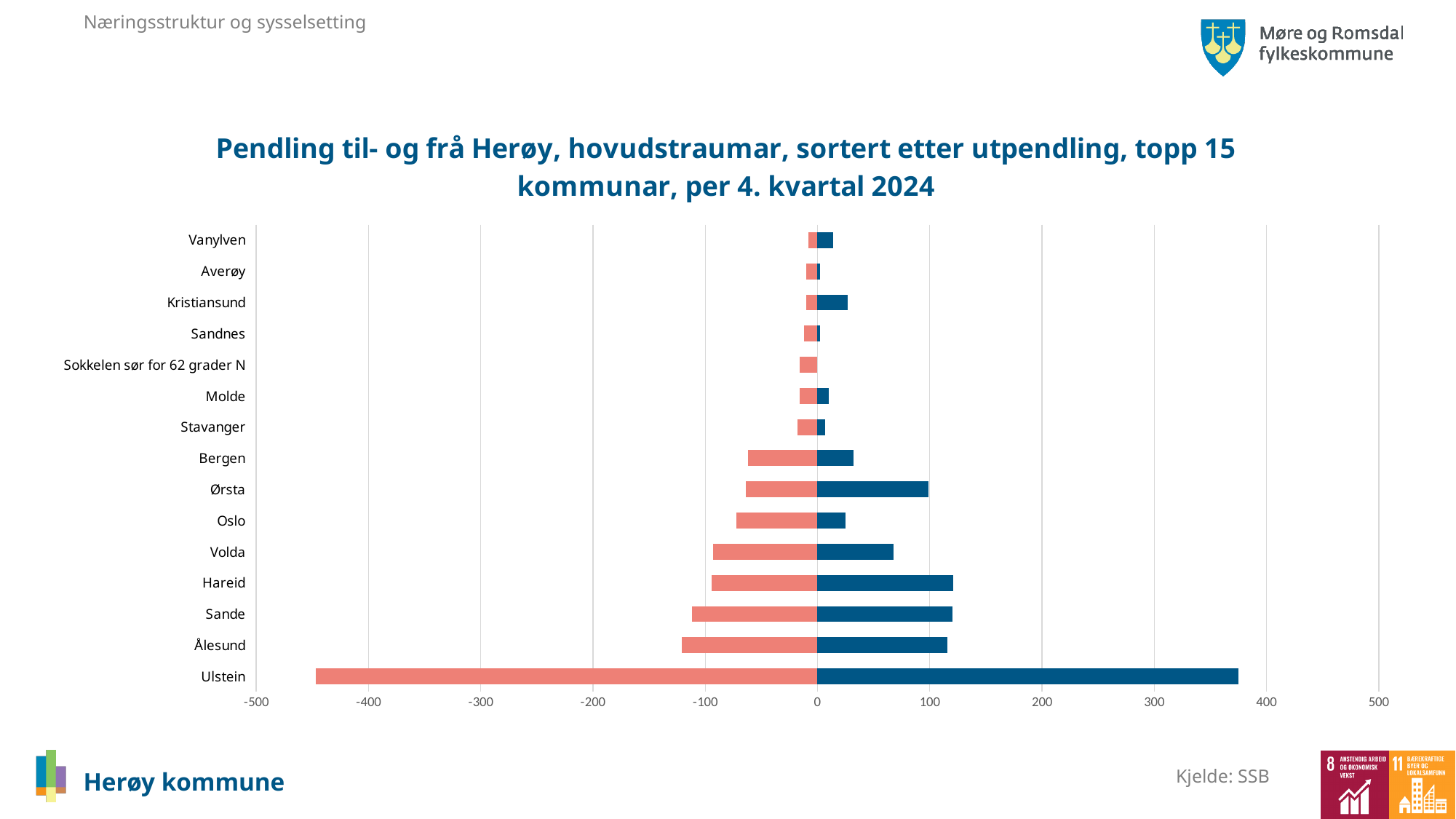
What is the source cited for the chart data? SSB Which municipality has the longest blue (positive) bar? Ulstein Is the blue (positive) value for Ålesund greater or less than 100? greater Is the red (negative) value for Ulstein greater or less than -400? less Is the red (negative) value for Ålesund greater or less than -100? less Which has the larger blue (positive) bar, Ørsta or Bergen? Ørsta How many municipalities (categories) are listed on the chart? 15 What kind of chart is shown on the slide? bar chart Which has the larger blue (positive) bar, Hareid or Volda? Hareid Which municipality has the longest red (negative) bar? Ulstein